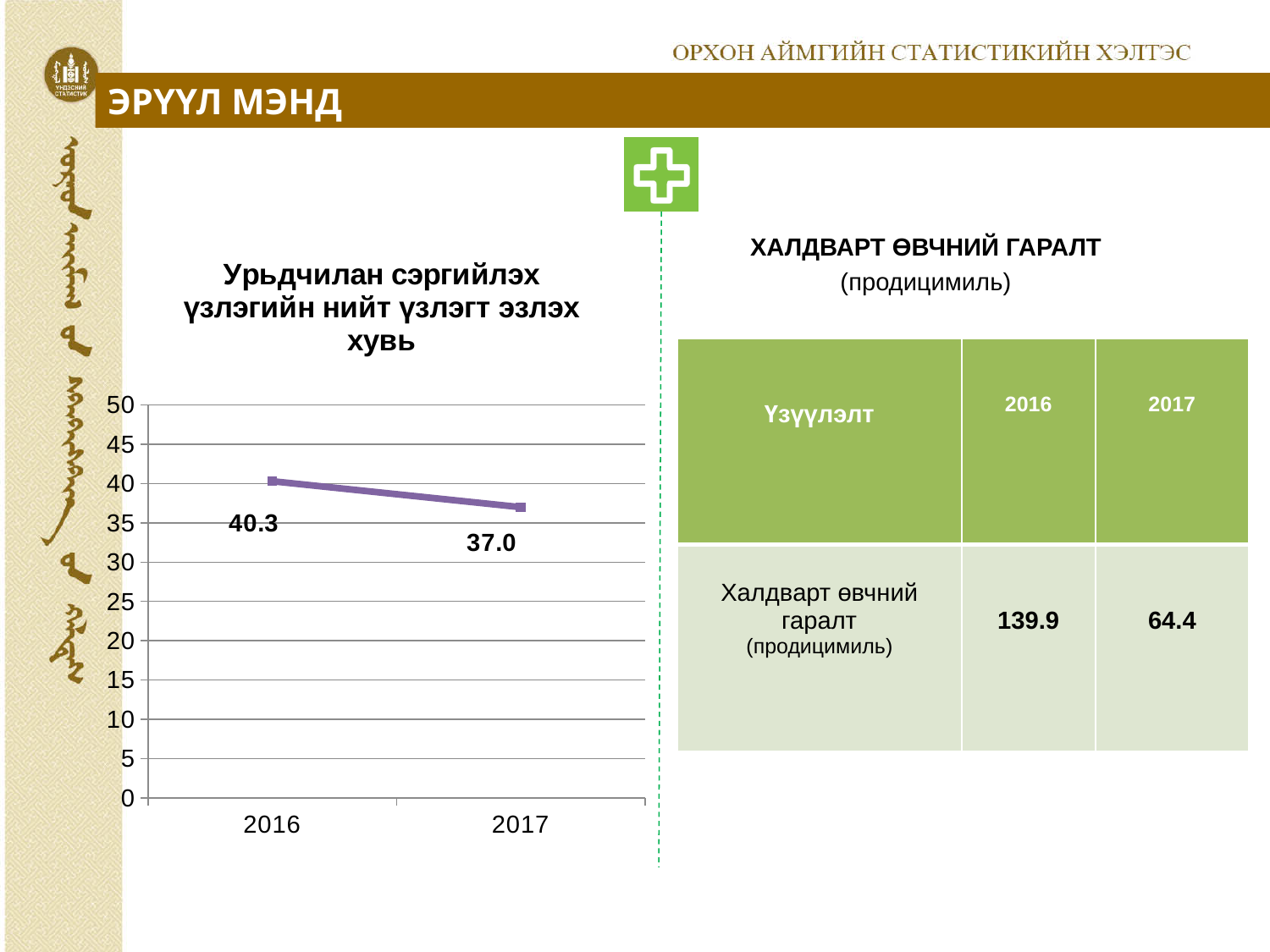
How many years are plotted on the x axis of the line chart? 2 What is the difference between the 2016 and 2017 values in the line chart? 3.3 What is the value for 2017 in the line chart? 37.0 Which year has the lowest value in the line chart? 2017 What is the highest tick value shown on the y axis of the line chart? 50 Is the value for 2017 in the line chart greater or less than 40? less What kind of chart is shown on the left of the slide? line chart What is the value for 2016 in the line chart? 40.3 Is the value for 2016 in the line chart greater or less than 35? greater Do the values in the line chart rise or fall from 2016 to 2017? fall Which year has the highest value in the line chart? 2016 Which is larger in the line chart, the value for 2016 or the value for 2017? 2016